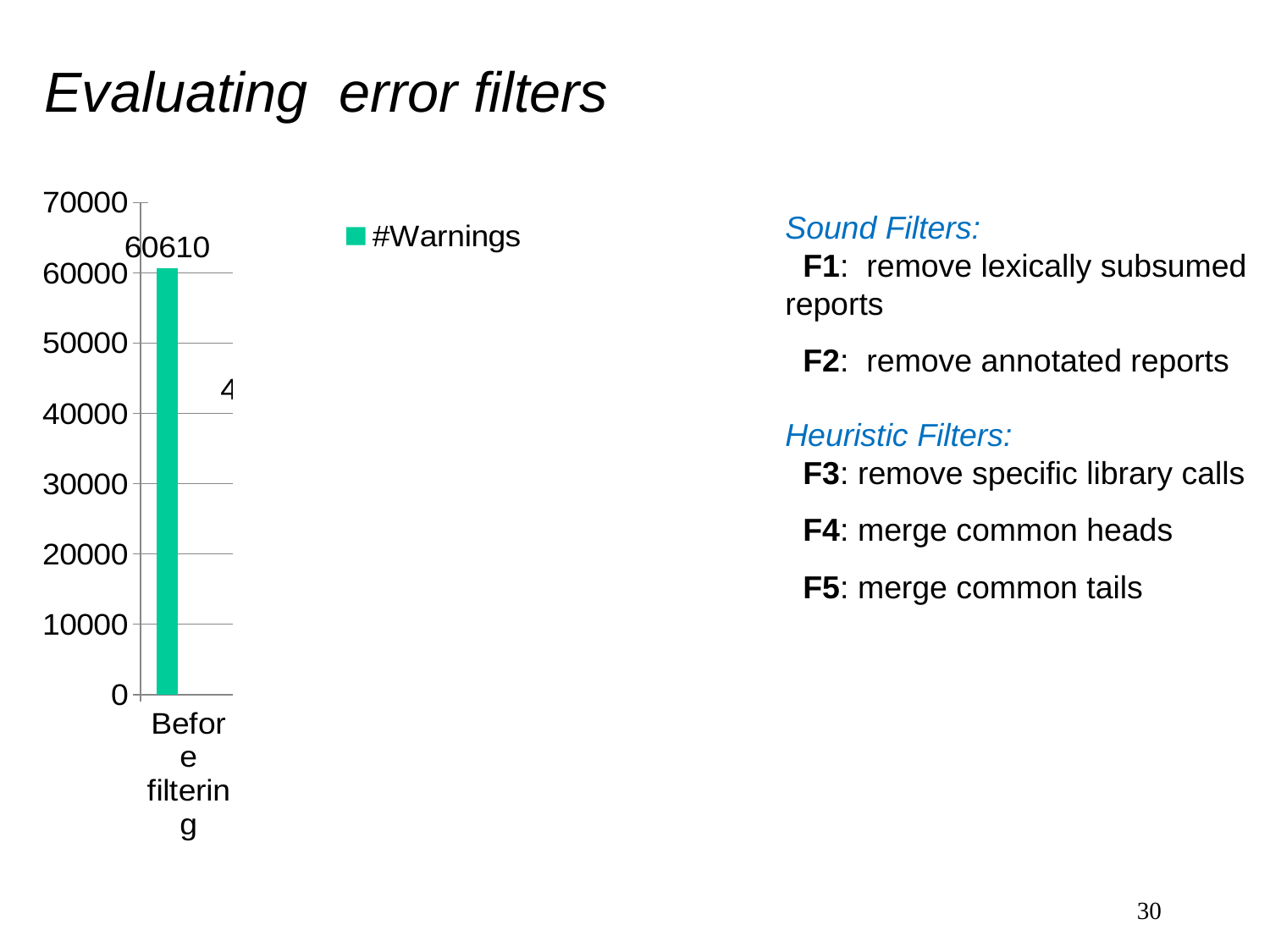
What kind of chart is shown on the slide? bar chart How many series does the chart legend list? 1 What series name is shown in the chart legend? #Warnings Is the value for "Before filtering" greater or less than 60000? greater Is the value for "Before filtering" greater or less than 70000? less What is the highest value shown on the chart's vertical axis? 70000 What is the value of #Warnings for "Before filtering"? 60610